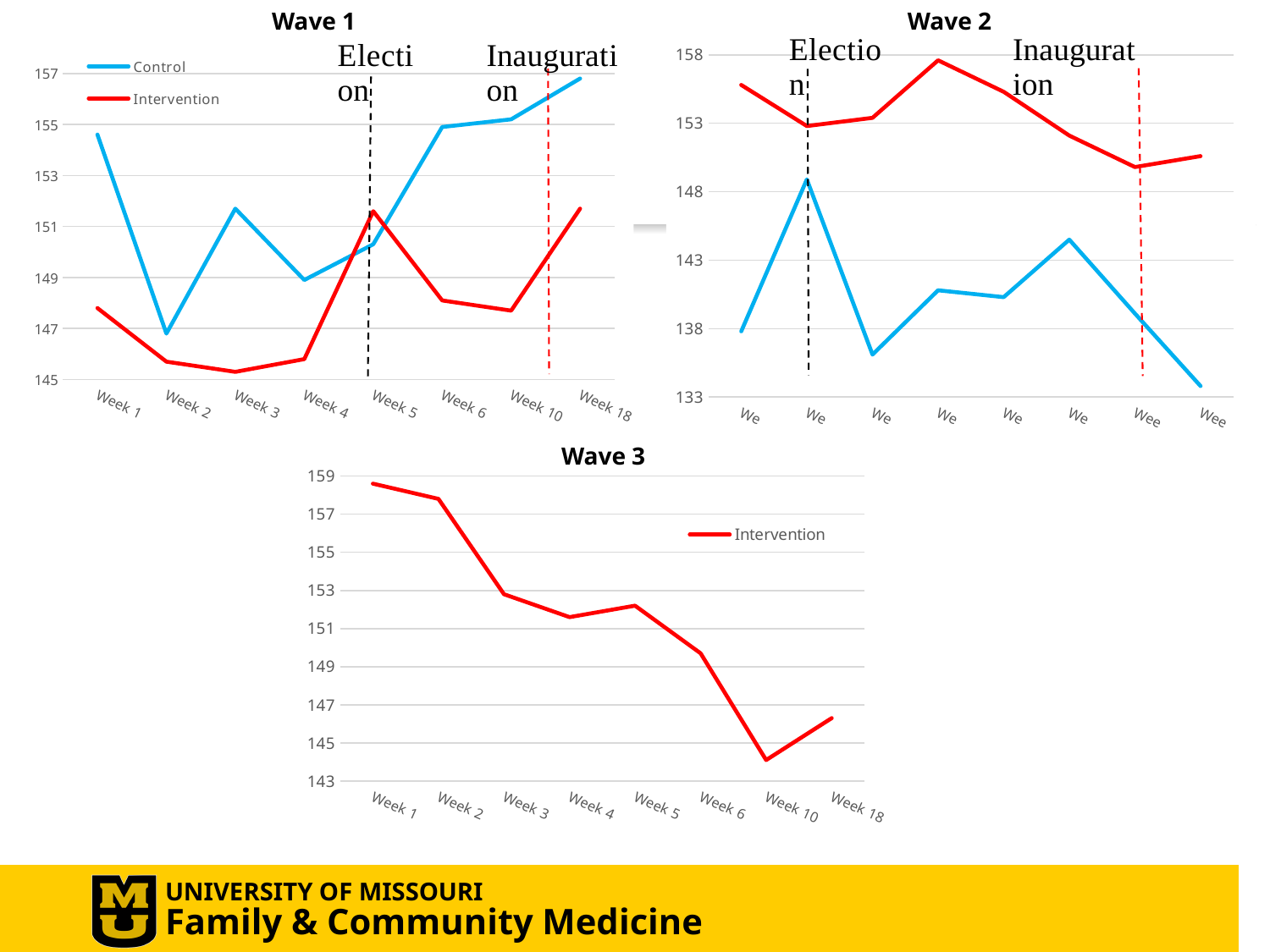
In the Wave 1 chart, is the Control value at Week 1 greater or less than 153? greater In the Wave 3 chart, at which week is the Intervention value highest? Week 1 What kind of chart is the Wave 1 chart? line chart How many week points are plotted on the x axis of the Wave 3 chart? 8 In the Wave 1 chart, at which week is the Control series lowest? Week 2 How many series does the legend of the Wave 3 chart list? 1 In the Wave 1 chart, which series has the larger value at Week 6, Control or Intervention? Control In the Wave 3 chart, does the Intervention line generally rise or fall from Week 1 to Week 10? fall In the Wave 1 chart, is the Control value at Week 18 greater or less than 155? greater In the Wave 1 chart, is the Intervention value at Week 3 greater or less than 147? less In the Wave 3 chart, at which week is the Intervention value lowest? Week 10 How many series does the legend of the Wave 1 chart list? 2